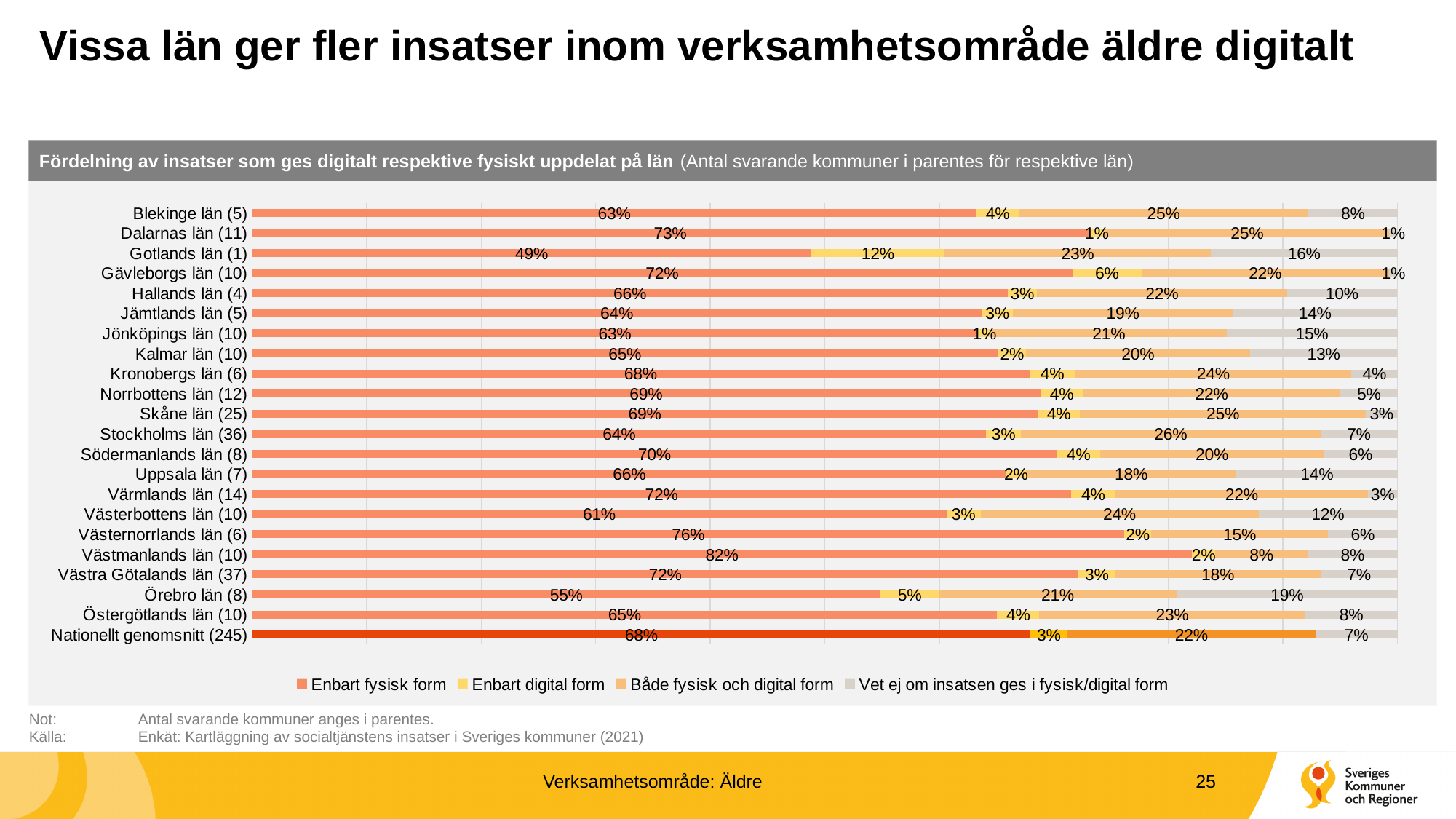
What is the 'Vet ej om insatsen ges i fysisk/digital form' value for Örebro län? 19% Which has a larger 'Både fysisk och digital form' share, Stockholms län or Västernorrlands län? Stockholms län Which län has the highest 'Enbart digital form' share? Gotlands län What is the 'Både fysisk och digital form' value for Nationellt genomsnitt? 22% What is the 'Enbart digital form' value for Gotlands län? 12% What kind of chart is shown on the slide? Stacked bar chart How many series does the legend list? 4 How many categories (rows) are shown in the chart? 22 What is the difference between the 'Enbart fysisk form' share of Västmanlands län and Örebro län? 27 percentage points Which län has the lowest 'Enbart fysisk form' share? Gotlands län What percentage of insatser in Västmanlands län are given in 'Enbart fysisk form'? 82% Which län has the highest 'Enbart fysisk form' share? Västmanlands län